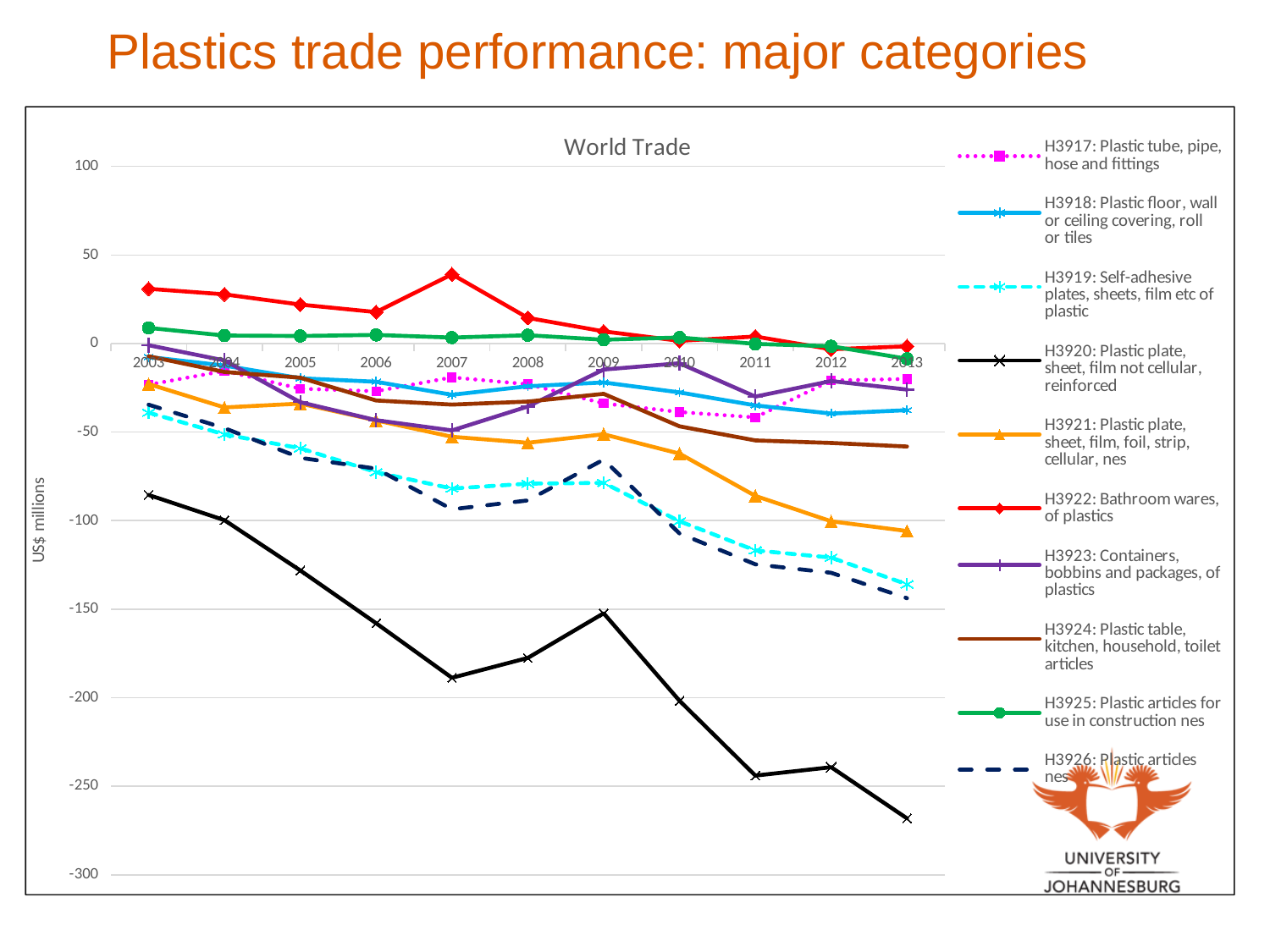
Is the value for H3919: Self-adhesive plates, sheets, film etc of plastic in 2013 greater or less than -100? less What is the title of the chart? World Trade How many years are plotted along the x axis? 11 Which series has the lowest value in 2013? H3920: Plastic plate, sheet, film not cellular, reinforced Which series has the highest value in 2007? H3922: Bathroom wares, of plastics Does the value for H3920: Plastic plate, sheet, film not cellular, reinforced rise or fall from 2003 to 2013? fall How many series does the legend list? 10 Is the value for H3922: Bathroom wares, of plastics in 2007 greater or less than 50? less Does the value for H3921: Plastic plate, sheet, film, foil, strip, cellular, nes rise or fall from 2003 to 2013? fall What kind of chart is shown on the slide? line chart Is the value for H3920: Plastic plate, sheet, film not cellular, reinforced in 2013 greater or less than -250? less What is the label on the vertical axis? US$ millions